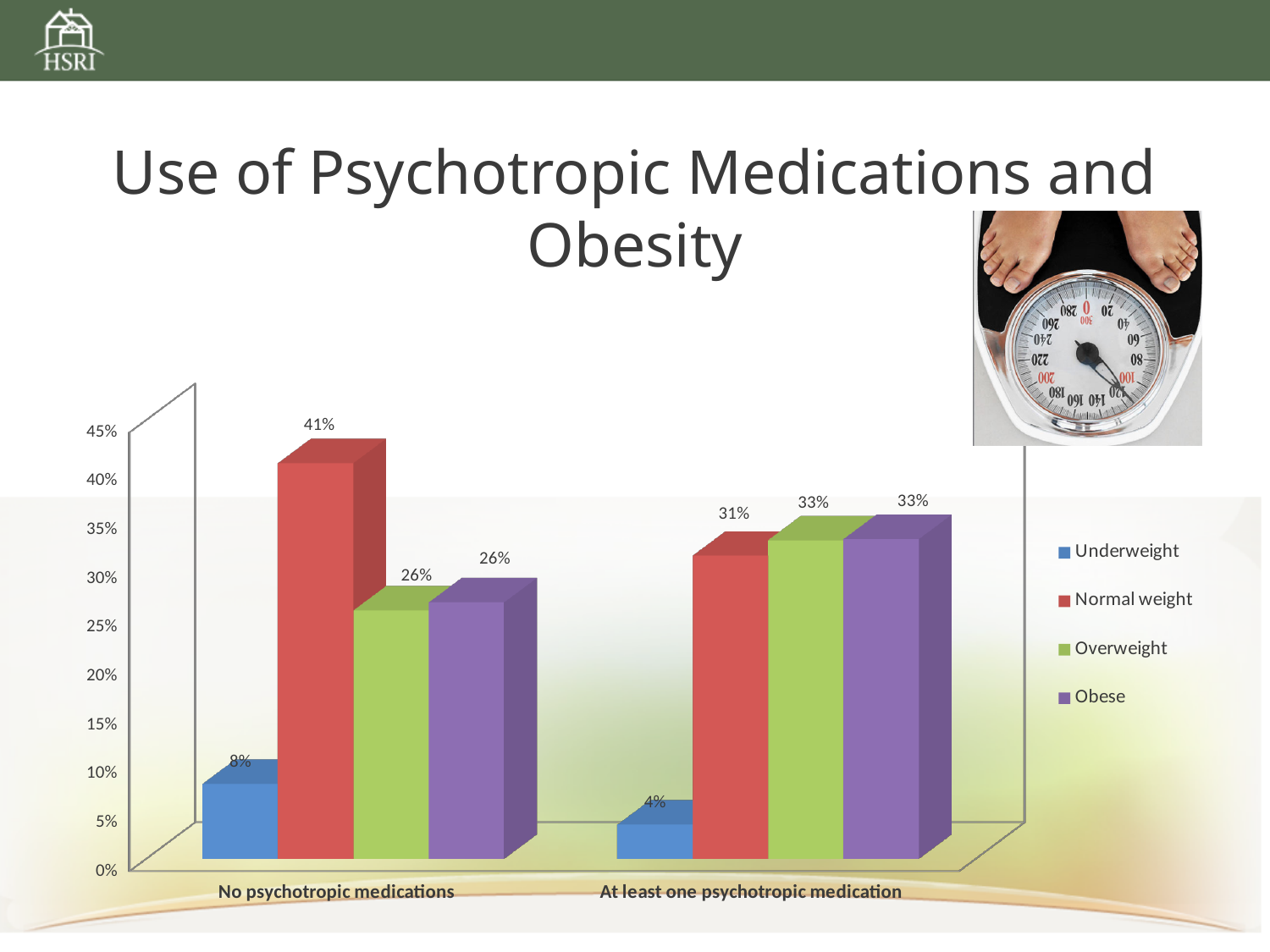
What is the value for Normal weight in the No psychotropic medications group? 41% Which weight category has the lowest value in the At least one psychotropic medication group? Underweight How many category groups are shown on the x axis? 2 What kind of chart is shown on the slide? Bar chart What is the difference between the Normal weight values for the No psychotropic medications group and the At least one psychotropic medication group? 10% What is the value for Underweight in the At least one psychotropic medication group? 4% What is the value for Obese in the At least one psychotropic medication group? 33% Which is larger: the Obese value for No psychotropic medications or the Obese value for At least one psychotropic medication? At least one psychotropic medication Which weight category has the highest value in the No psychotropic medications group? Normal weight How many series does the legend list? 4 What is the value for Overweight in the No psychotropic medications group? 26% What colour represents the Overweight series in the chart? Green